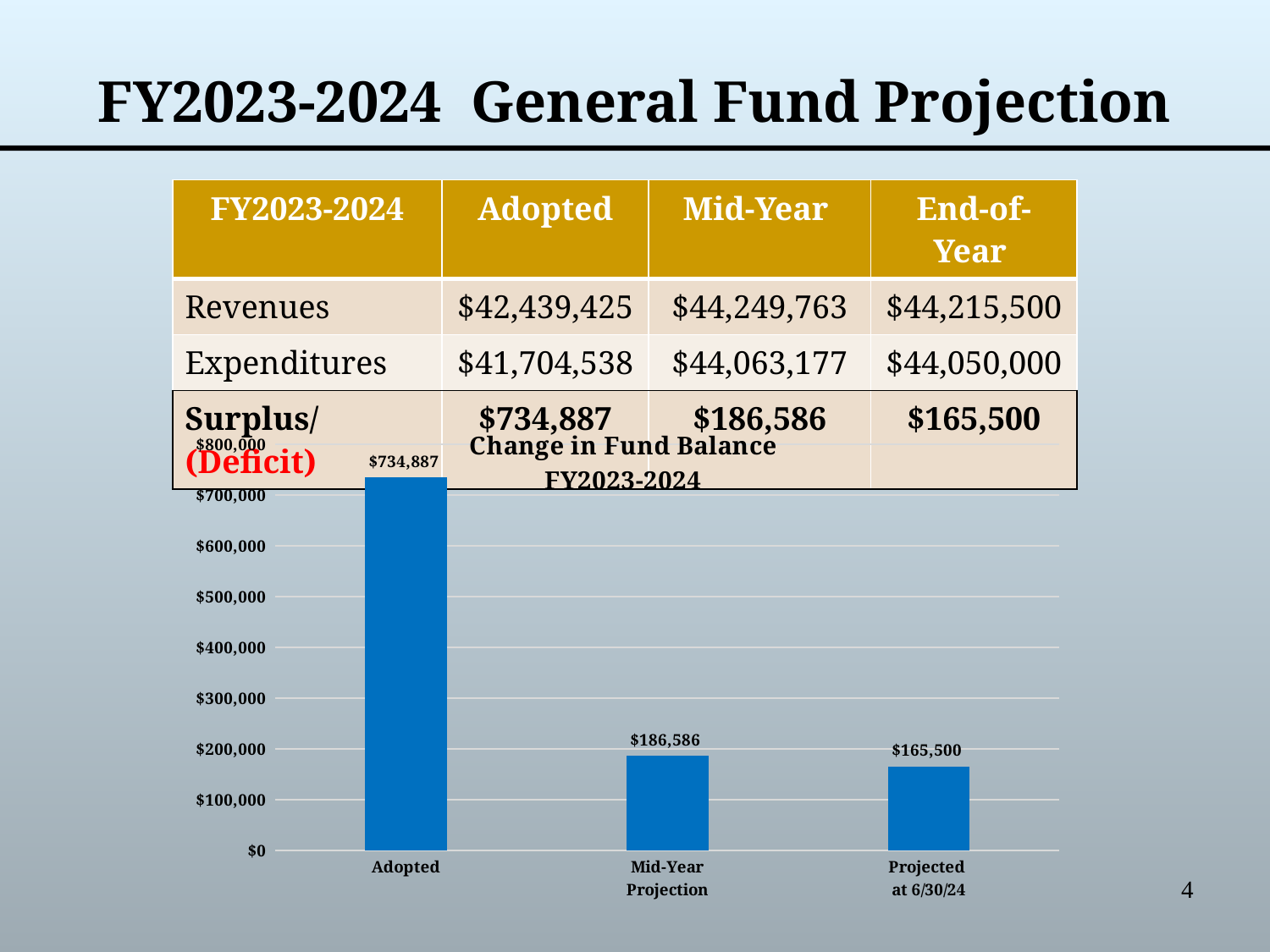
Is the value for Adopted greater or less than $700,000? greater Which category has the lowest value in the Change in Fund Balance chart? Projected at 6/30/24 Which category has the highest value in the Change in Fund Balance chart? Adopted What is the value of the Projected at 6/30/24 bar in the Change in Fund Balance chart? $165,500 What is the value of the Adopted bar in the Change in Fund Balance chart? $734,887 What kind of chart is shown on the slide? Bar chart What is the difference between the Mid-Year Projection value and the Projected at 6/30/24 value in the chart? $21,086 Which is larger in the chart, the Mid-Year Projection value or the Projected at 6/30/24 value? Mid-Year Projection How many bars are shown in the Change in Fund Balance chart? 3 What is the difference between the Adopted value and the Mid-Year Projection value in the chart? $548,301 What is the value of the Mid-Year Projection bar in the Change in Fund Balance chart? $186,586 Do the values in the chart rise or fall from Adopted to Projected at 6/30/24? Fall